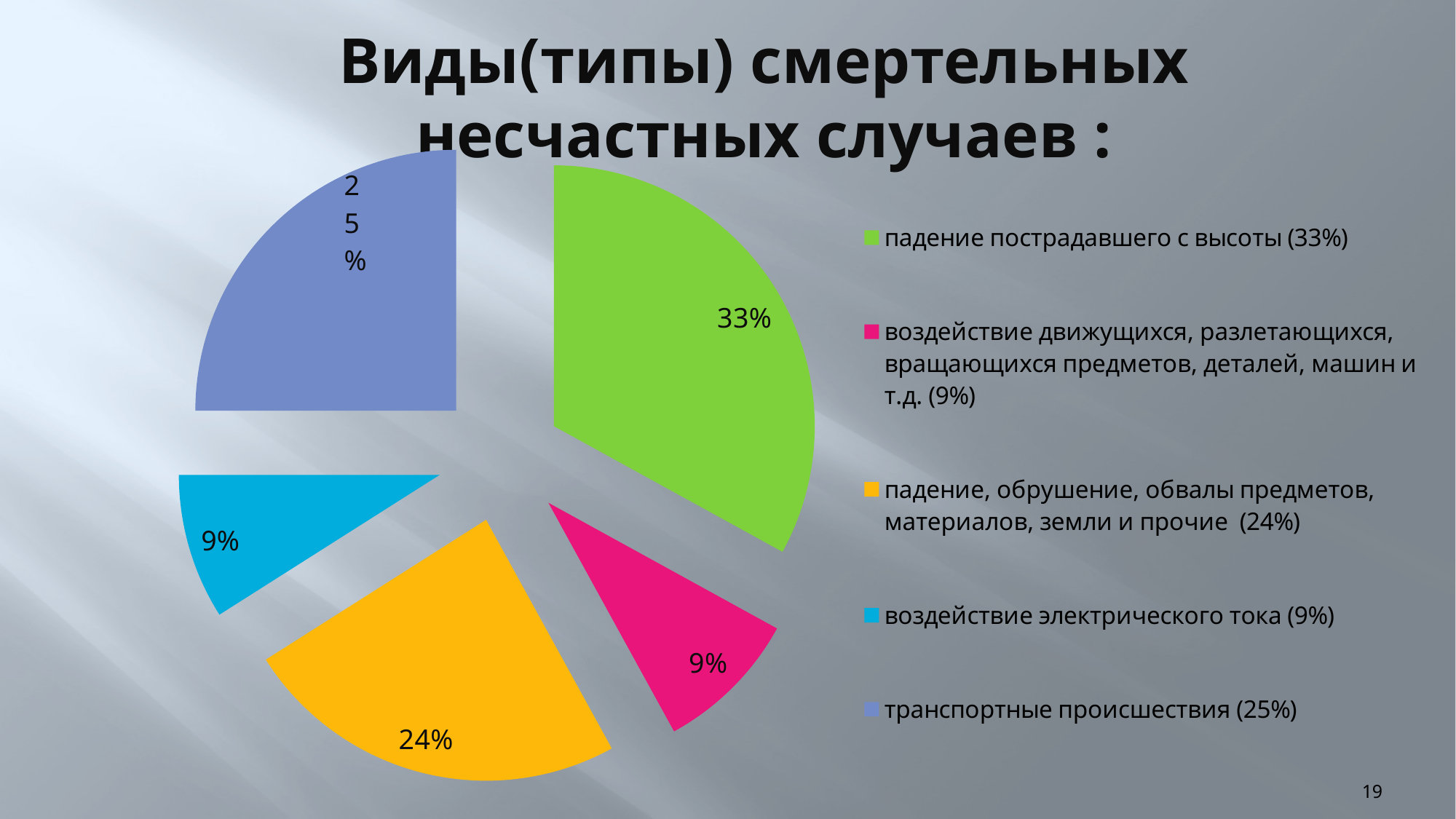
What share of the pie do "воздействие электрического тока" and "воздействие движущихся, разлетающихся, вращающихся предметов, деталей, машин и т.д." make up together? 18% How many slices does the pie chart have? 5 How many entries does the legend list? 5 What colour is the slice for "падение пострадавшего с высоты"? Green What kind of chart is shown on the slide? Pie chart What is the difference in percentage points between "падение пострадавшего с высоты" and "транспортные происшествия"? 8 What percentage is shown for "воздействие электрического тока"? 9% Which category has the largest slice of the pie? падение пострадавшего с высоты What percentage is shown for "транспортные происшествия"? 25% Which is larger: "транспортные происшествия" or "падение, обрушение, обвалы предметов, материалов, земли и прочие"? транспортные происшествия What percentage is shown for "падение пострадавшего с высоты"? 33% What percentage is shown for "падение, обрушение, обвалы предметов, материалов, земли и прочие"? 24%